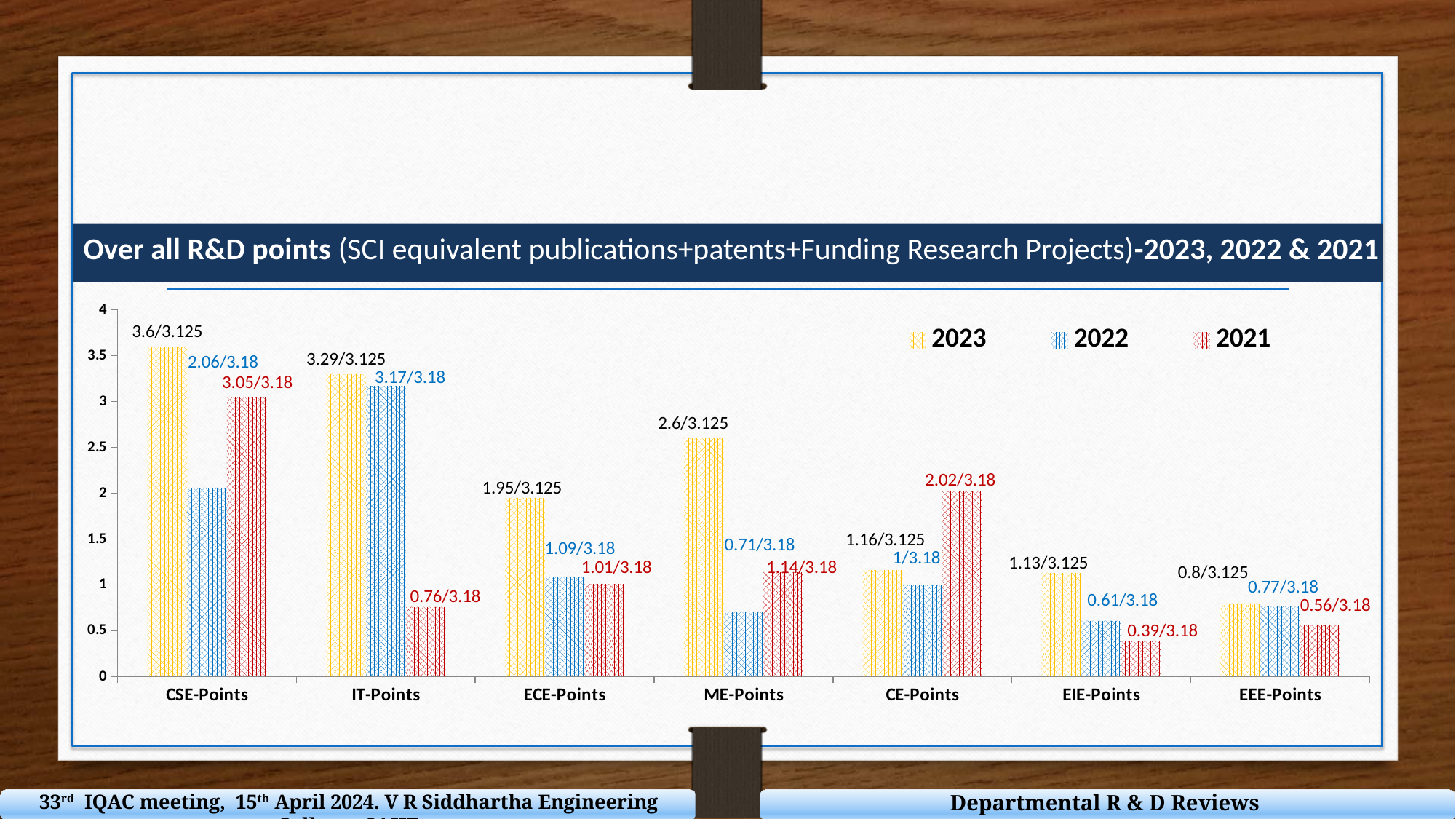
Which department has the highest 2023 value? CSE-Points Is the 2021 value for IT-Points greater or less than 1? less Which department has the lowest 2021 value? EIE-Points How many departments are shown on the x axis? 7 What is the data label for IT-Points in the 2022 series? 3.17/3.18 What is the data label for CE-Points in the 2021 series? 2.02/3.18 What kind of chart is shown on the slide? bar chart What is the data label for CSE-Points in the 2023 series? 3.6/3.125 What is the data label for EEE-Points in the 2023 series? 0.8/3.125 For CSE-Points, which is larger: the 2022 value or the 2021 value? 2021 What is the data label for ME-Points in the 2022 series? 0.71/3.18 How many series does the legend list? 3